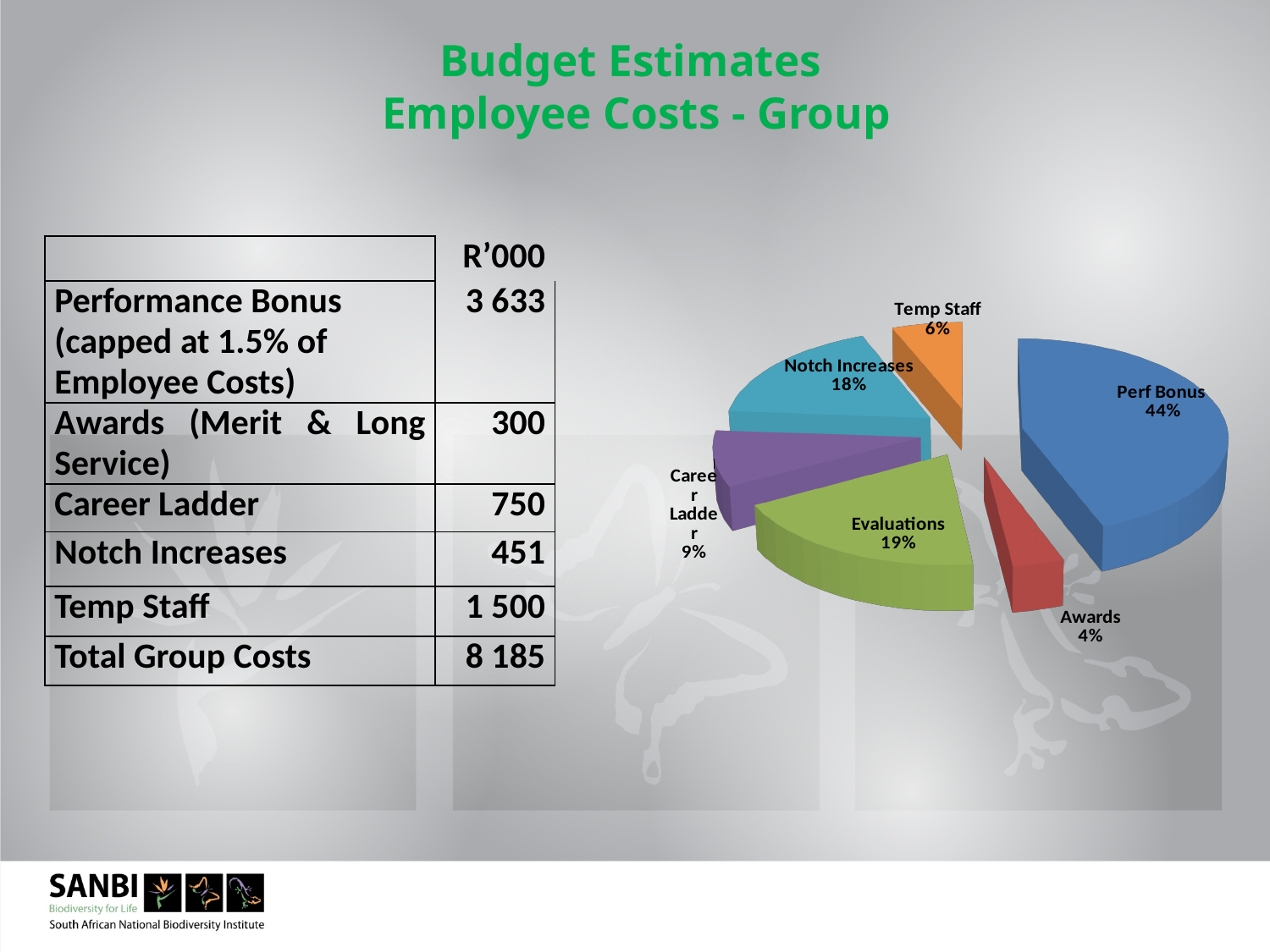
What kind of chart is shown on the slide? pie chart What share of the pie does Temp Staff represent? 6% Which slice of the pie chart is the largest? Perf Bonus Which slice of the pie chart is the smallest? Awards What colour is the Perf Bonus slice in the pie chart? blue Which is larger in the pie chart, Evaluations or Notch Increases? Evaluations What share of the pie does Notch Increases represent? 18% What is the difference in percentage points between the Perf Bonus slice and the Evaluations slice? 25 What share of the pie does Awards represent? 4% How many slices does the pie chart have? 6